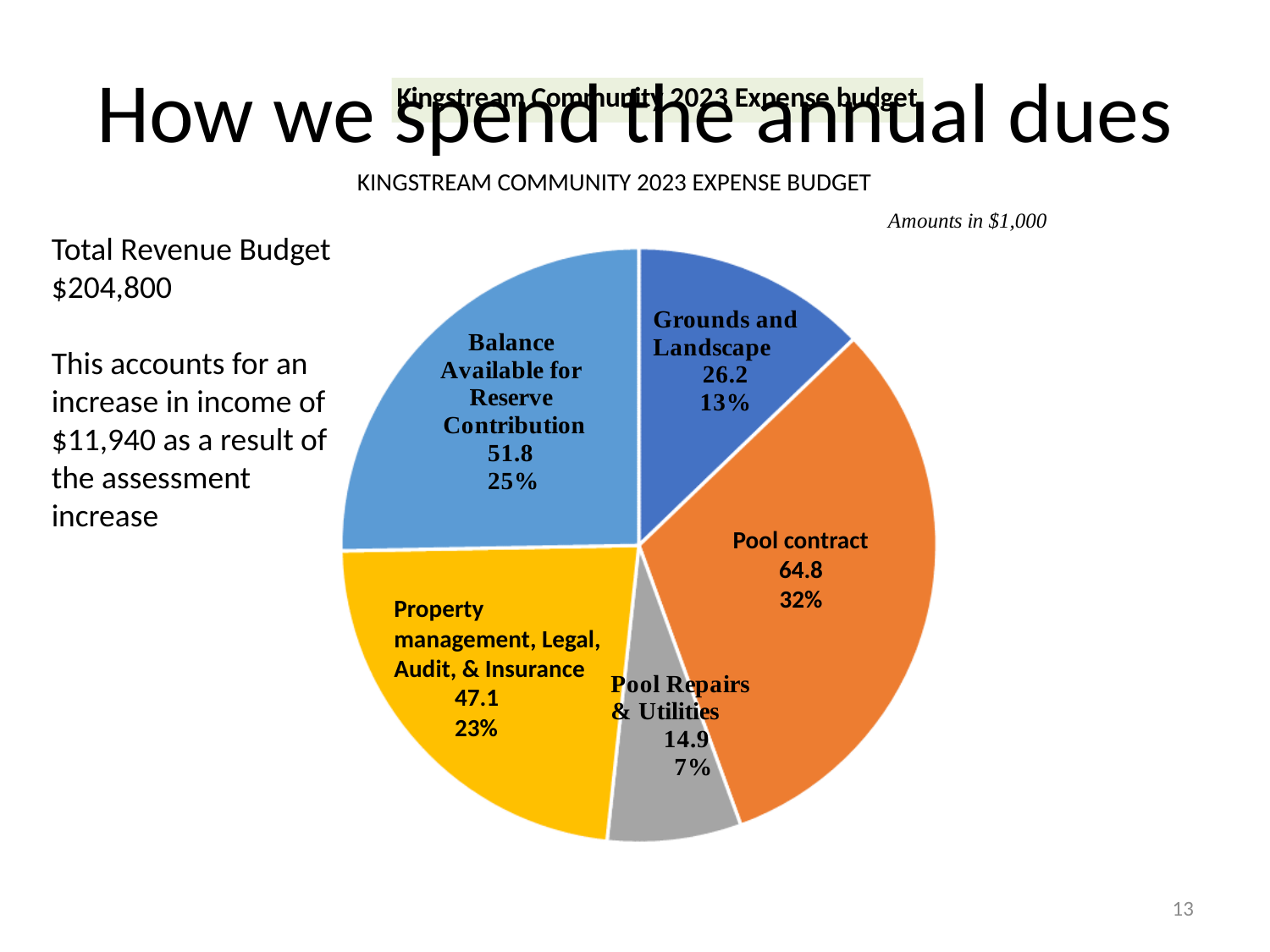
How many categories are shown in the pie chart? 5 Which category has the largest slice of the pie? Pool contract What share of the pie does Balance Available for Reserve Contribution represent? 25% Which category has the smallest slice of the pie? Pool Repairs & Utilities What is the value for Pool contract? 64.8 In what units are the amounts in the chart expressed, according to the note on the slide? Amounts in $1,000 Which is larger, the value for Balance Available for Reserve Contribution or the value for Property management, Legal, Audit, & Insurance? Balance Available for Reserve Contribution What share of the pie does Property management, Legal, Audit, & Insurance represent? 23% What is the value for Grounds and Landscape? 26.2 What is the value for Pool Repairs & Utilities? 14.9 What is the difference between the values for Pool contract and Grounds and Landscape? 38.6 What kind of chart is shown on the slide? Pie chart